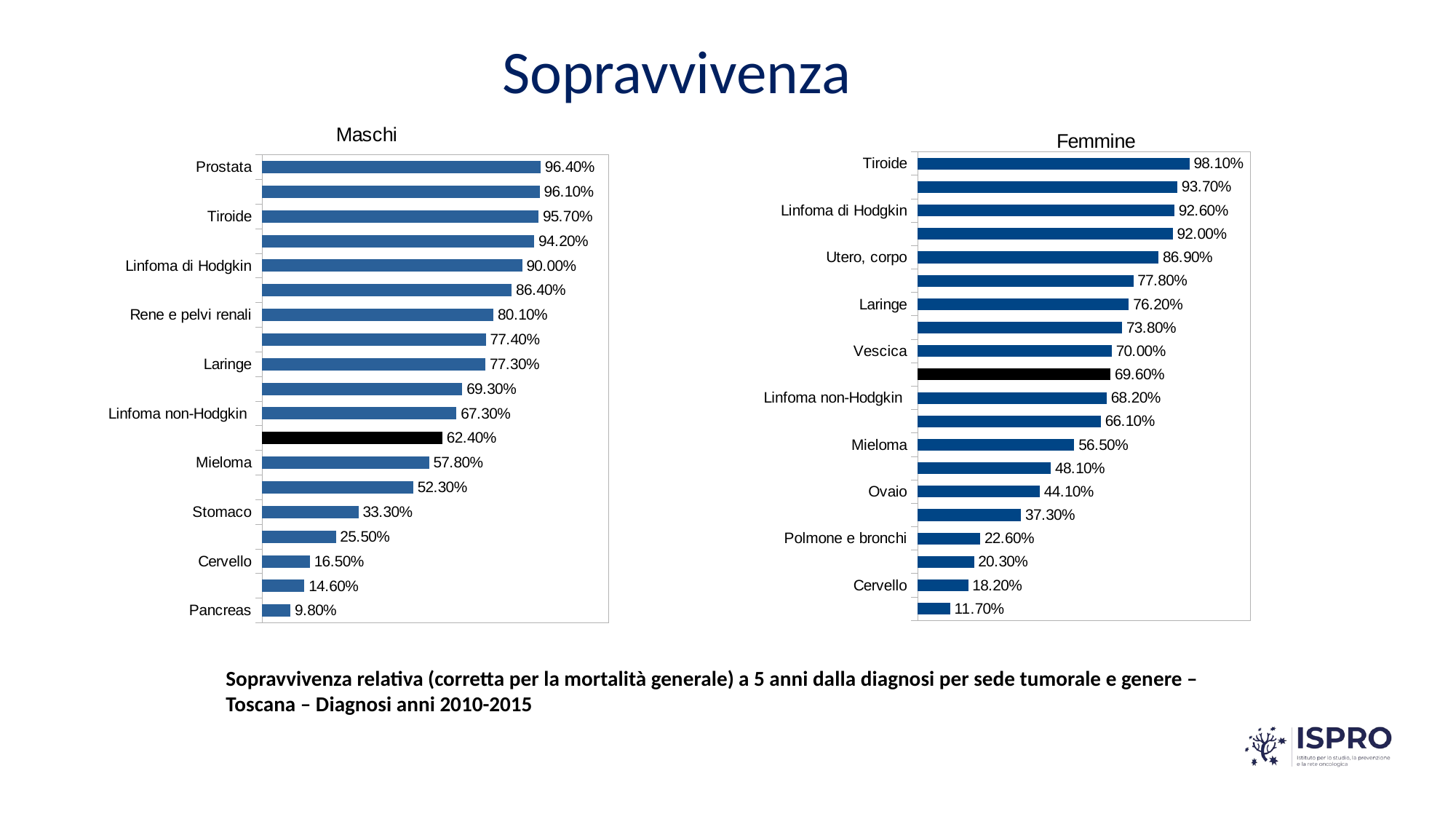
Which is larger: the value for Tiroide in the Maschi chart or the value for Tiroide in the Femmine chart? Femmine In the Maschi chart, what is the difference between the values for Prostata and Pancreas? 86.60% In the Femmine chart, which category has the highest value? Tiroide In the Femmine chart, what is the difference between the values for Tiroide and Cervello? 79.90% In the Femmine chart, what is the value for Utero, corpo? 86.90% In the Maschi chart, what is the value for Prostata? 96.40% In the Maschi chart, what is the value for Stomaco? 33.30% What kind of chart is the Maschi chart? Bar chart How many bars are plotted in the Femmine chart? 20 In the Maschi chart, which category has the lowest value? Pancreas In the Femmine chart, what is the value for Ovaio? 44.10% In the Maschi chart, which category has the highest value? Prostata